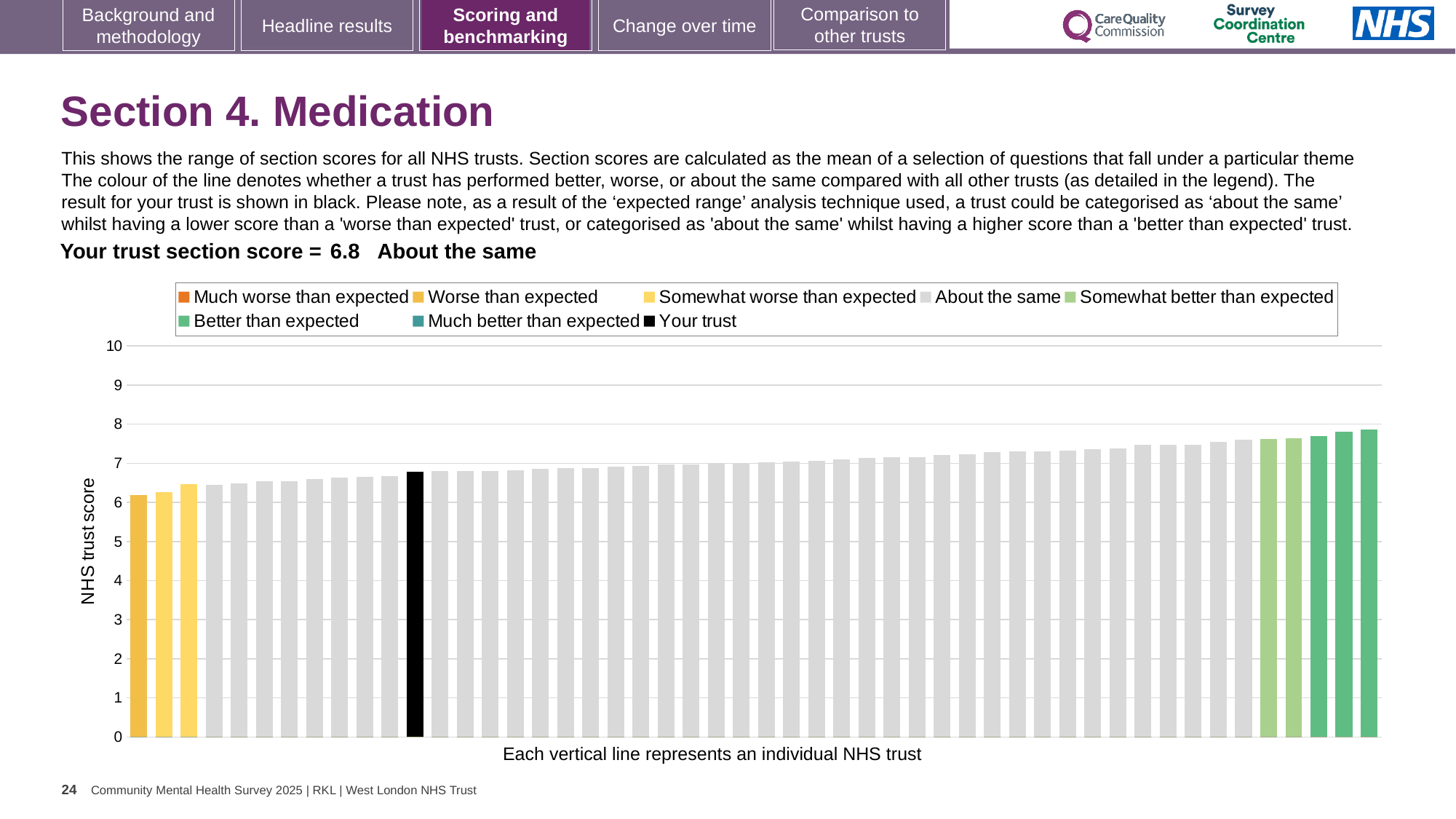
What is the highest value shown on the y axis? 10 How many entries does the chart legend list? 8 Do the bar values rise or fall from left to right along the x axis? rise What is the section score for your trust shown on the slide? 6.8 Is the value of the tallest bar greater or less than 7? greater What colour is the bar representing your trust? black Which performance category is your trust's section score placed in? About the same Is the value of the black 'Your trust' bar greater or less than 5? greater What kind of chart is shown on the slide? bar chart Is the value of the shortest bar greater or less than 7? less Which bar is taller, the leftmost bar or the rightmost bar? the rightmost bar